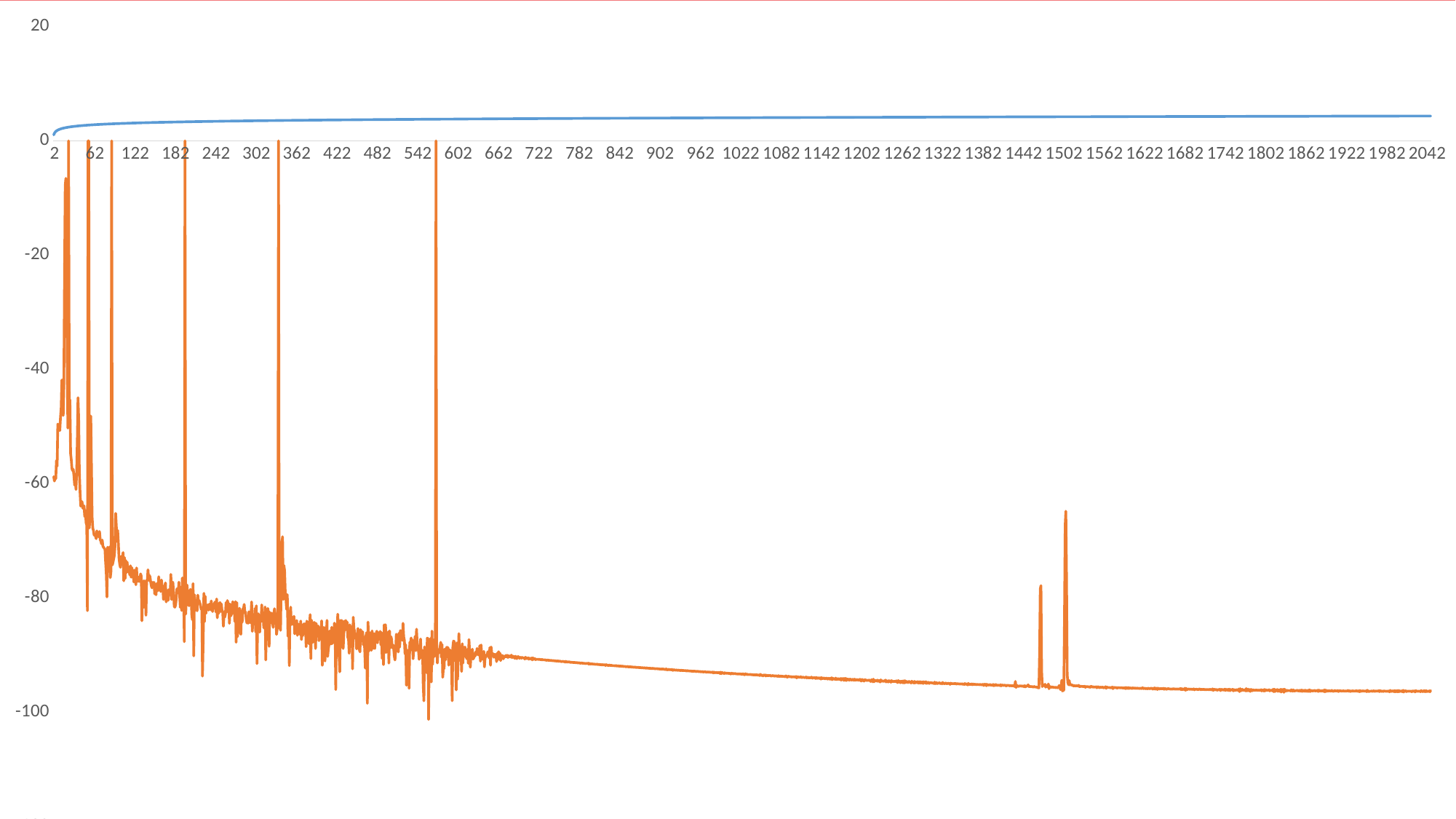
What colours are the two lines on the chart? blue and orange What is the first label on the horizontal axis? 2 Does the orange line generally rise or fall as the x axis increases? fall Which line is higher on the chart, the blue line or the orange line? the blue line What kind of chart is shown on the slide? line chart Is the value of the blue line at x = 2042 greater or less than 0? greater What is the lowest value labelled on the vertical axis? -100 How many lines are plotted on the chart? 2 What is the last label on the horizontal axis? 2042 Is the value of the orange line at x = 1022 greater or less than -60? less Is the value of the orange line at x = 2042 greater or less than -80? less What is the highest value labelled on the vertical axis? 20